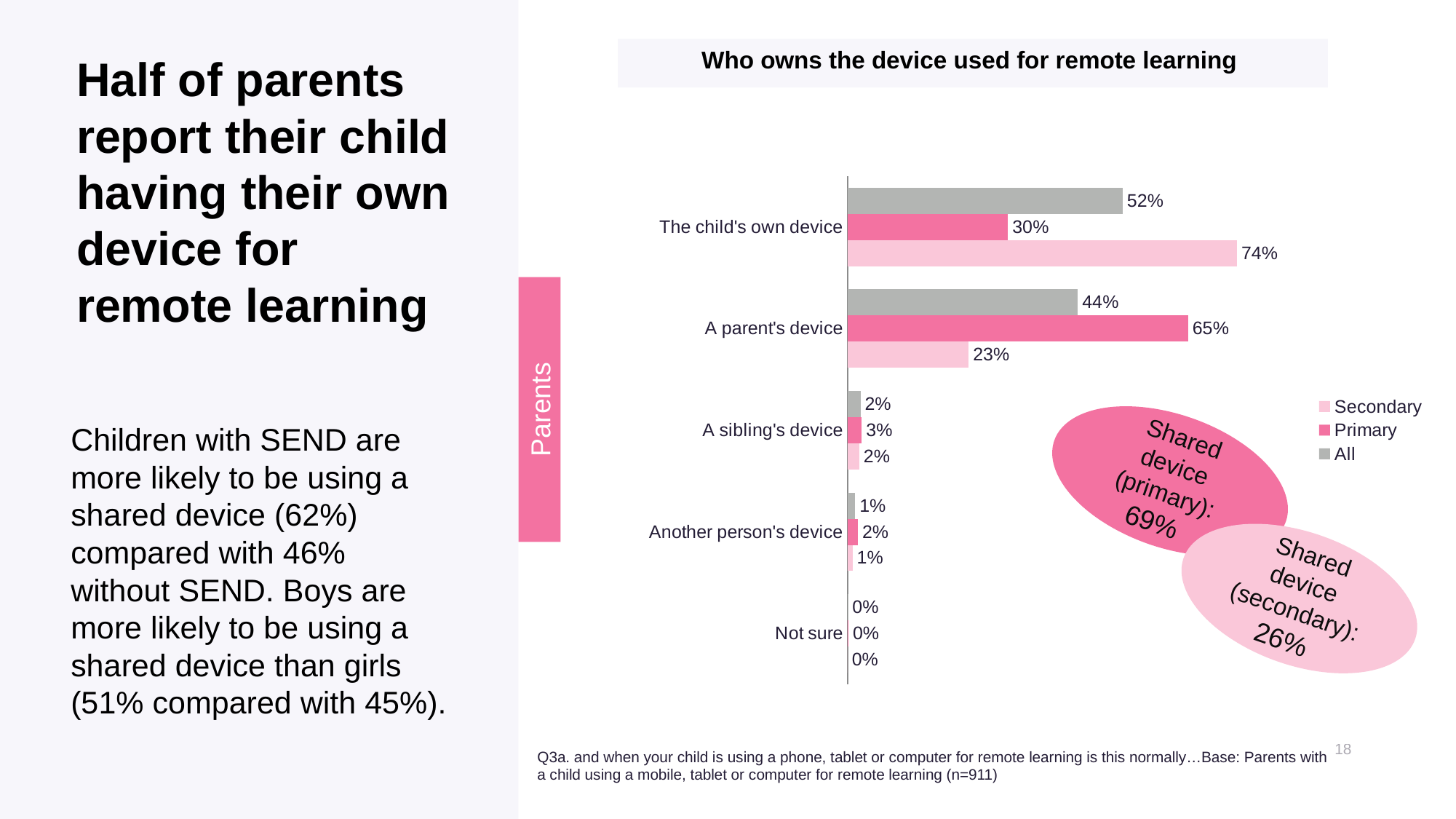
What is the difference between the Secondary and Primary values for 'The child's own device'? 44 percentage points How many categories are shown on the chart? 5 Which category has the highest value in the All series? The child's own device What is the title of the chart? Who owns the device used for remote learning Which category has the highest value in the Primary series? A parent's device What is the difference between the All values for 'The child's own device' and 'A parent's device'? 8 percentage points How many series does the legend list? 3 What is the value for 'A sibling's device' in the All series? 2% What is the value for 'A parent's device' in the Primary series? 65% What kind of chart is shown on the slide? Bar chart Which is larger for 'A parent's device': the All value or the Secondary value? All What is the value for 'The child's own device' in the Secondary series? 74%